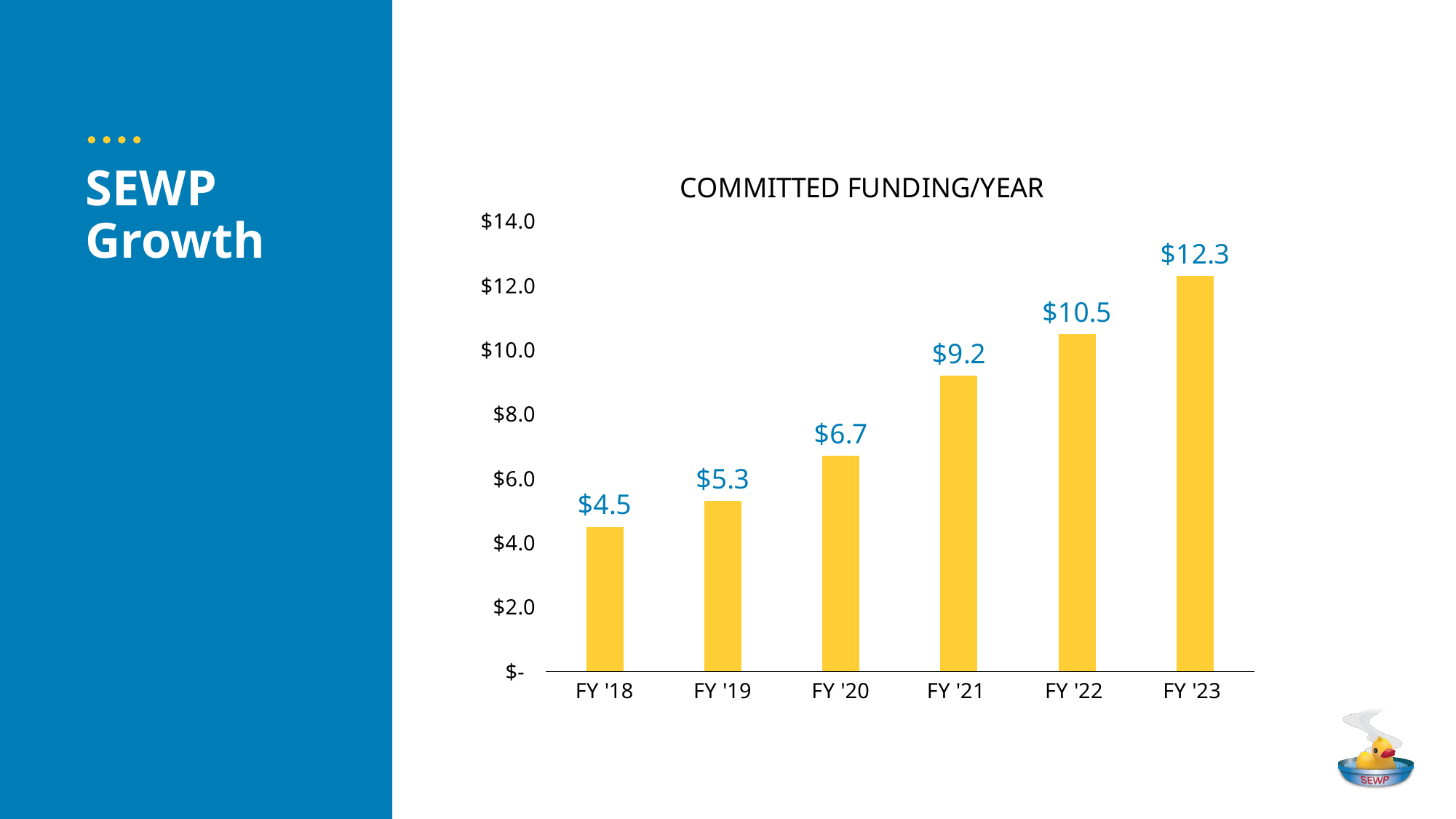
Which fiscal year has the lowest committed funding? FY '18 What is the committed funding for FY '20? $6.7 What is the title of the chart? COMMITTED FUNDING/YEAR What is the committed funding for FY '22? $10.5 How many fiscal years are shown on the chart? 6 Does committed funding rise or fall from FY '18 to FY '23? Rise Which fiscal year has the highest committed funding? FY '23 Is the committed funding for FY '22 greater or less than $10.0? greater What kind of chart is shown on the slide? Bar chart What is the difference in committed funding between FY '23 and FY '18? $7.8 Which has higher committed funding, FY '19 or FY '21? FY '21 What is the difference in committed funding between FY '21 and FY '19? $3.9